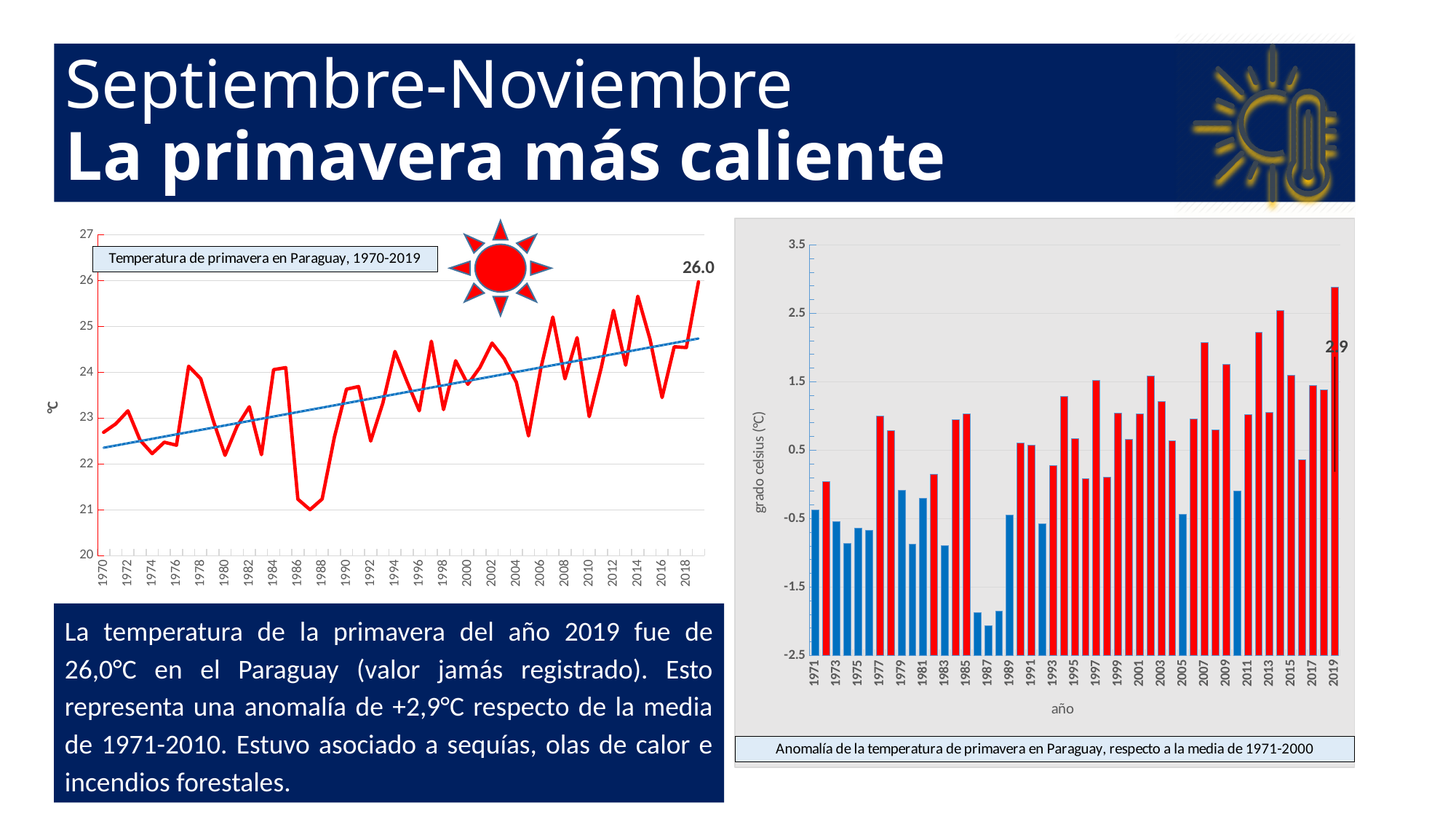
In the left chart 'Temperatura de primavera en Paraguay, 1970-2019', which is larger, the value for 2019 or the value for 1987? 2019 In the right chart 'Anomalía de la temperatura de primavera en Paraguay', what is the label on the x axis? año In the right chart 'Anomalía de la temperatura de primavera en Paraguay', which year has the highest anomaly? 2019 In the left chart 'Temperatura de primavera en Paraguay, 1970-2019', do the values generally rise or fall from 1970 to 2019? rise In the left chart 'Temperatura de primavera en Paraguay, 1970-2019', is the value for 1987 greater or less than 22? less In the right chart 'Anomalía de la temperatura de primavera en Paraguay', what is the value labelled for 2019? 2.9 In the right chart 'Anomalía de la temperatura de primavera en Paraguay', is the value for 2019 greater or less than 2.5? greater What kind of chart is the right chart, 'Anomalía de la temperatura de primavera en Paraguay'? bar chart In the right chart 'Anomalía de la temperatura de primavera en Paraguay', is the value for 1987 greater or less than -1.5? less In the left chart 'Temperatura de primavera en Paraguay, 1970-2019', which year has the highest temperature? 2019 In the left chart 'Temperatura de primavera en Paraguay, 1970-2019', what is the value labelled for 2019? 26.0 What kind of chart is the left chart, 'Temperatura de primavera en Paraguay, 1970-2019'? line chart